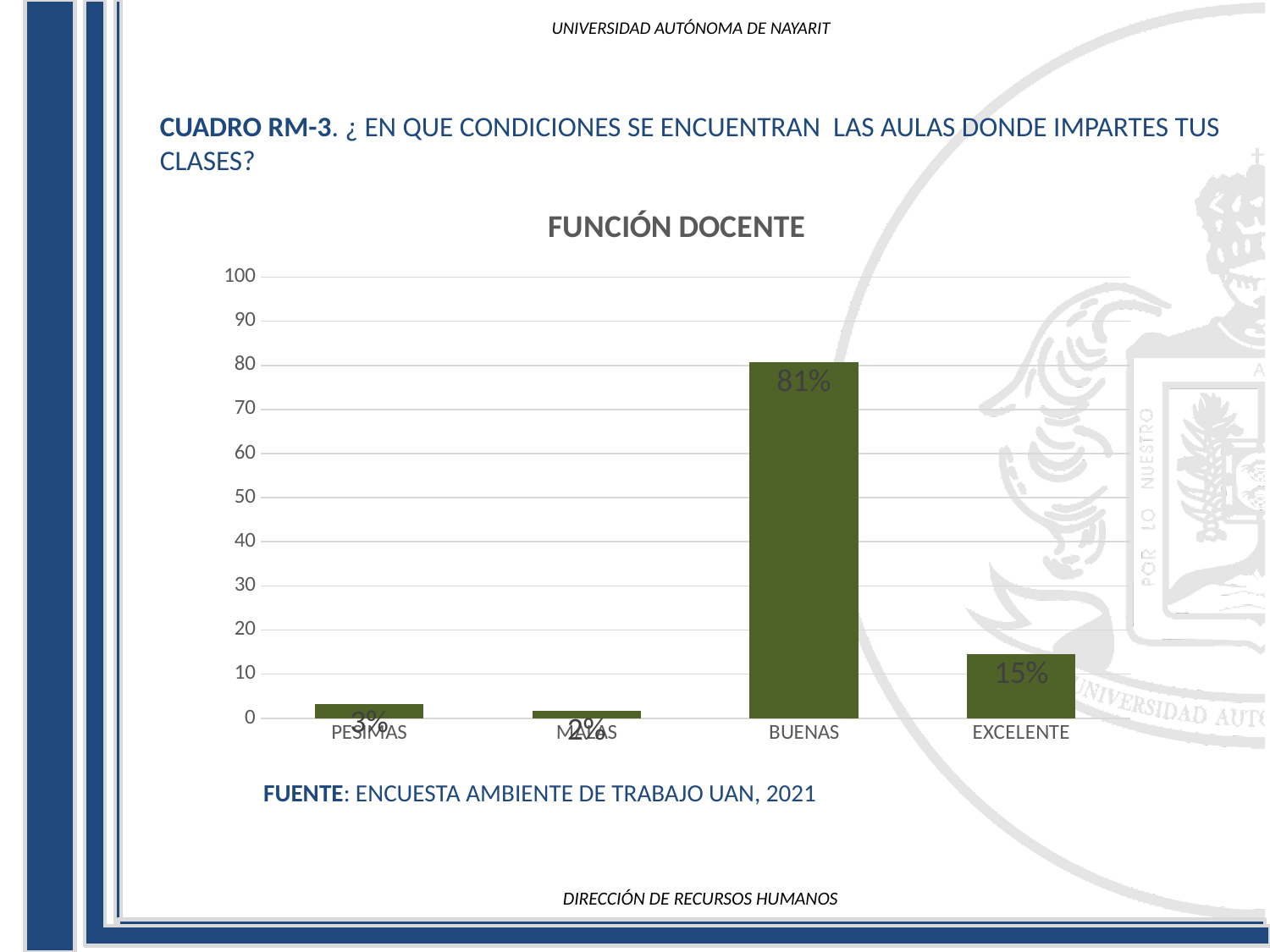
What is the difference between the values for BUENAS and EXCELENTE? 66% What kind of chart is shown on the slide? bar chart How many categories are shown on the x axis? 4 What is the value for MALAS? 2% Is the value for BUENAS greater or less than 70? greater What is the title of the chart? FUNCIÓN DOCENTE Which is larger, the value for EXCELENTE or the value for PÉSIMAS? EXCELENTE Which category has the highest value? BUENAS What is the value for PÉSIMAS? 3% Which category has the lowest value? MALAS What is the value for BUENAS? 81% What is the value for EXCELENTE? 15%